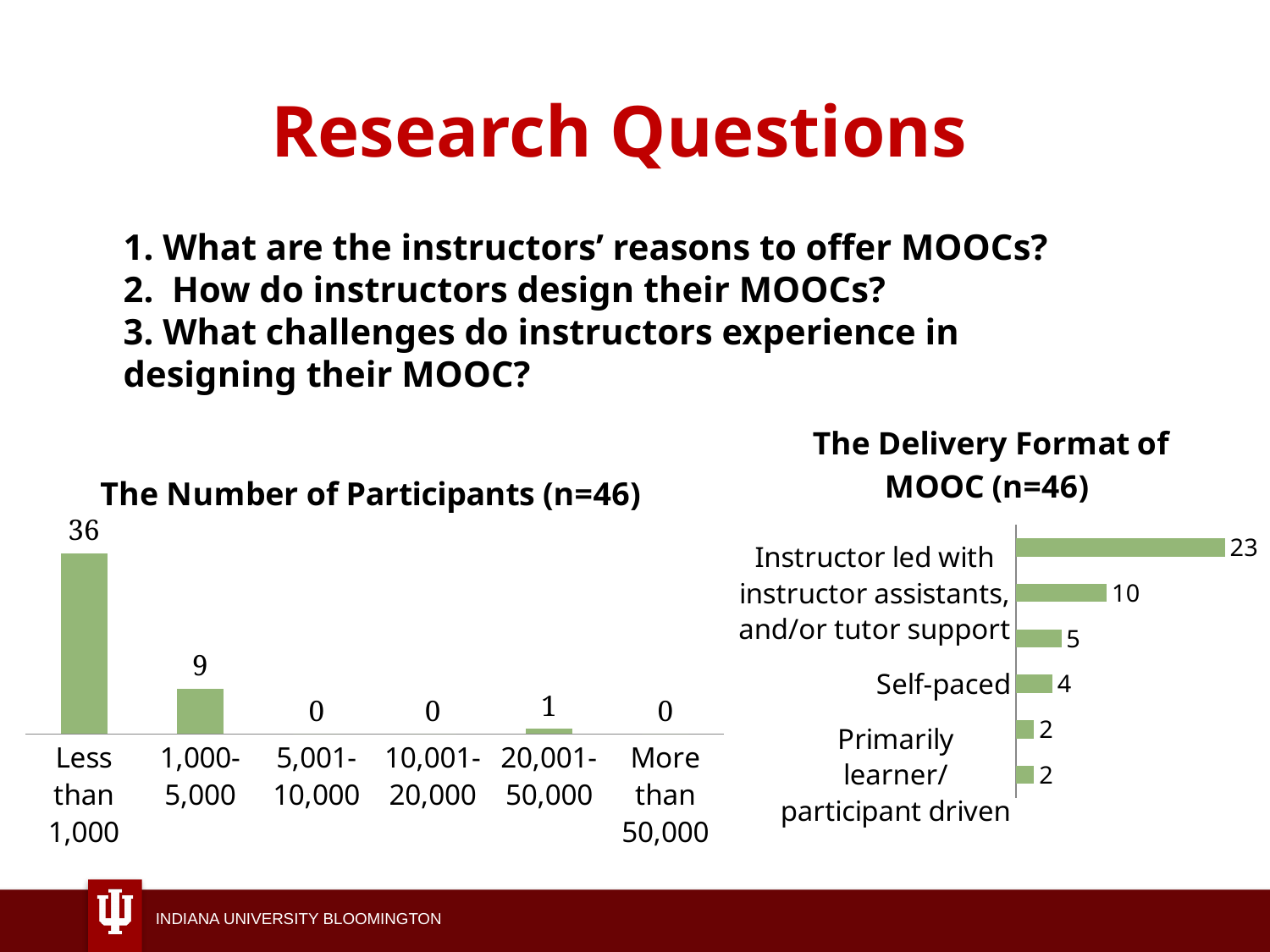
In the chart titled "The Number of Participants (n=46)", what is the value for "20,001-50,000"? 1 What kind of chart is "The Number of Participants (n=46)"? Bar chart In the chart titled "The Delivery Format of MOOC (n=46)", what is the highest value shown? 23 In the chart titled "The Number of Participants (n=46)", how many categories are shown on the x axis? 6 In the chart titled "The Number of Participants (n=46)", how many categories have a value of 0? 3 In the chart titled "The Number of Participants (n=46)", what is the value for "Less than 1,000"? 36 In the chart titled "The Delivery Format of MOOC (n=46)", how many bars are plotted? 6 In the chart titled "The Delivery Format of MOOC (n=46)", what is the value for "Self-paced"? 4 What kind of chart is "The Delivery Format of MOOC (n=46)"? Bar chart In the chart titled "The Number of Participants (n=46)", what is the value for "1,000-5,000"? 9 In the chart titled "The Number of Participants (n=46)", what is the difference between the values for "Less than 1,000" and "1,000-5,000"? 27 In the chart titled "The Number of Participants (n=46)", which category has the highest value? Less than 1,000